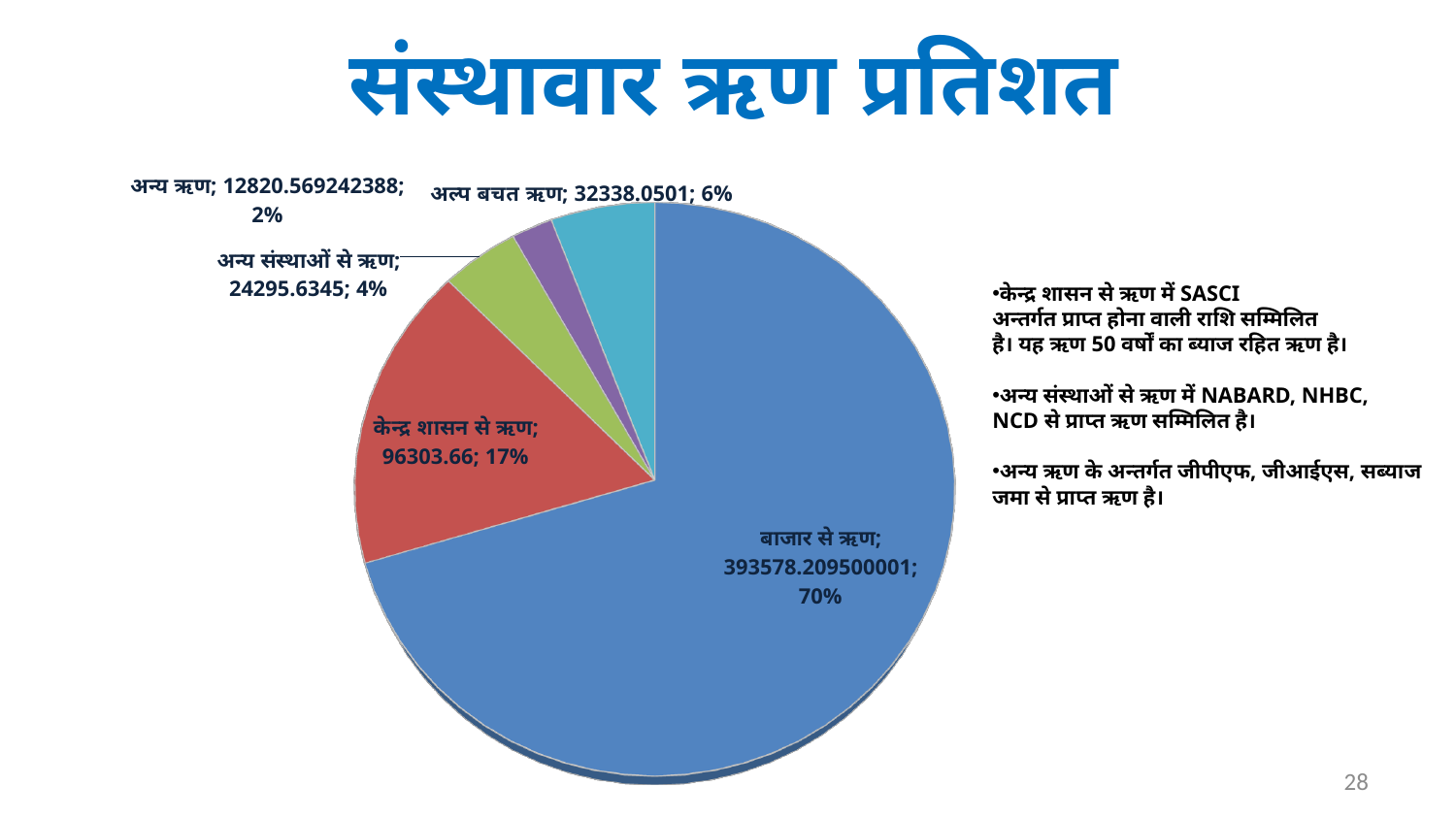
Which category has the largest slice of the pie? बाजार से ऋण What value is shown for अल्प बचत ऋण? 32338.0501 What is the title of the chart? संस्थावार ऋण प्रतिशत What percentage share of the pie does अन्य ऋण have? 2% Which category has the smallest slice of the pie? अन्य ऋण What percentage share of the pie does बाजार से ऋण have? 70% What value is shown for अन्य संस्थाओं से ऋण? 24295.6345 What kind of chart is shown on the slide? Pie chart What value is shown for बाजार से ऋण? 393578.209500001 What value is shown for केन्द्र शासन से ऋण? 96303.66 How many slices does the pie chart have? 5 Which is larger, the value for अल्प बचत ऋण or the value for अन्य संस्थाओं से ऋण? अल्प बचत ऋण